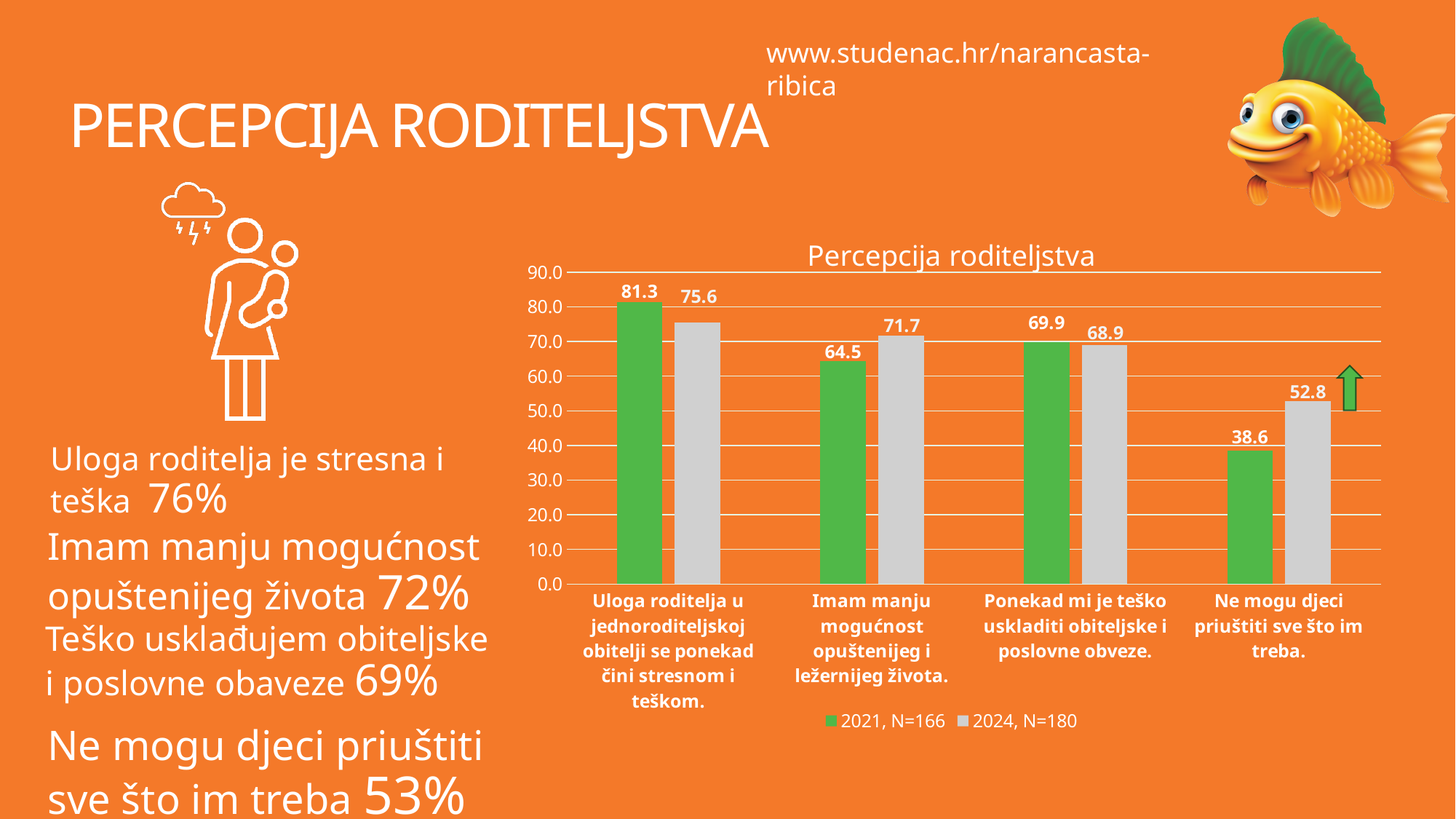
What is the difference between the 2024, N=180 and 2021, N=166 values for "Ne mogu djeci priuštiti sve što im treba."? 14.2 What is the 2024, N=180 value for "Imam manju mogućnost opuštenijeg i ležernijeg života."? 71.7 For "Uloga roditelja u jednoroditeljskoj obitelji se ponekad čini stresnom i teškom.", which series has the larger value, 2021, N=166 or 2024, N=180? 2021, N=166 Which category has the lowest 2024, N=180 value? Ne mogu djeci priuštiti sve što im treba. How many categories are shown on the x axis of the chart? 4 Which category has the highest 2021, N=166 value? Uloga roditelja u jednoroditeljskoj obitelji se ponekad čini stresnom i teškom. What is the 2021, N=166 value for "Ne mogu djeci priuštiti sve što im treba."? 38.6 How many series does the chart legend list? 2 What is the 2021, N=166 value for "Ponekad mi je teško uskladiti obiteljske i poslovne obveze."? 69.9 What type of chart is shown on the slide? bar chart Which series is shown in green in the chart? 2021, N=166 What is the title of the chart? Percepcija roditeljstva